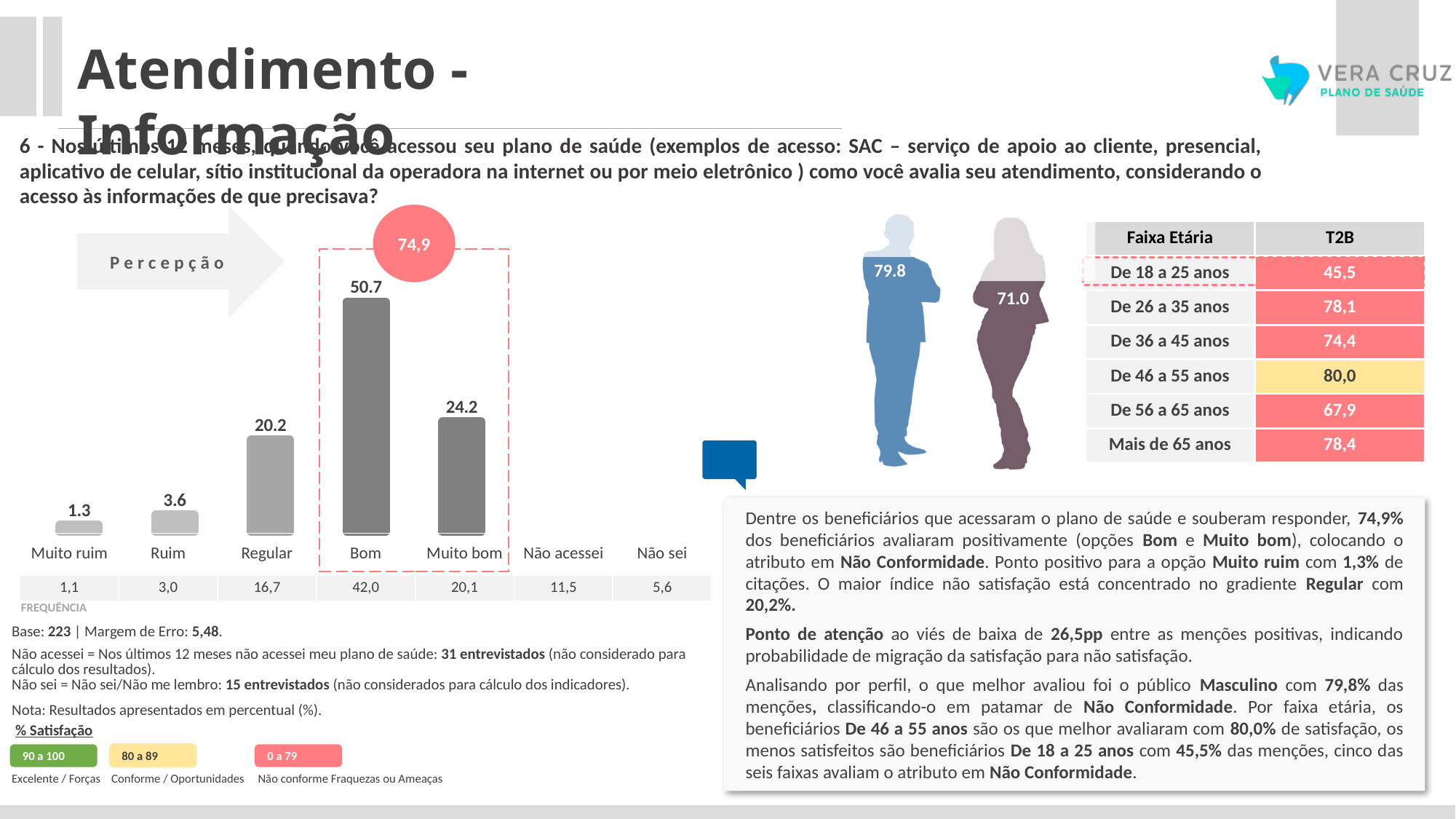
What is the difference between the Bom and Muito bom values in the bar chart? 26.5 Which category has the highest bar in the bar chart? Bom In the bar chart, which is larger: the value for Muito bom or the value for Regular? Muito bom What value is shown in the red circle above the dashed box around Bom and Muito bom? 74,9 What kind of chart is shown on the left of the slide? Bar chart How many bars are plotted in the bar chart? 5 What is the value shown for the Muito ruim bar in the bar chart? 1.3 What is the value shown for the Bom bar in the bar chart? 50.7 Which category has the lowest bar in the bar chart? Muito ruim What is the difference between the Regular and Ruim values in the bar chart? 16.6 What is the value shown for the Regular bar in the bar chart? 20.2 What is the value shown for the Muito bom bar in the bar chart? 24.2